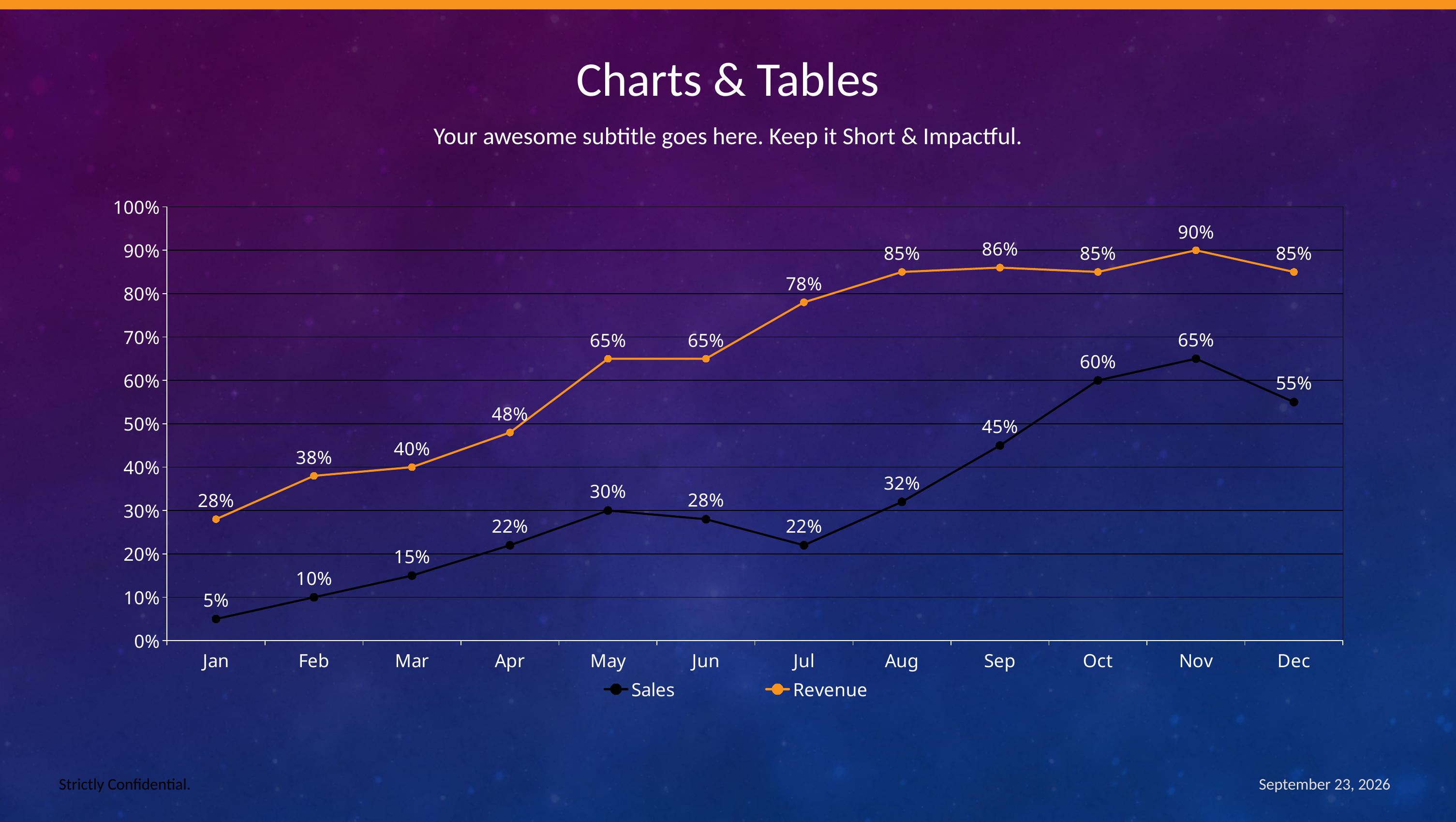
What is the Sales value for May? 30% What is the Revenue value for Jul? 78% Does the Sales line rise or fall from Jan to Apr? Rise In which month is Revenue highest? Nov What colour is the Revenue line? Orange How many months are shown on the x axis? 12 How many series does the legend list? 2 Is the Sales value for Sep greater or less than 40%? greater Which is larger in Jun: Sales or Revenue? Revenue What is the difference between Revenue and Sales in Oct? 25% In which month is Sales lowest? Jan What kind of chart is shown on the slide? Line chart